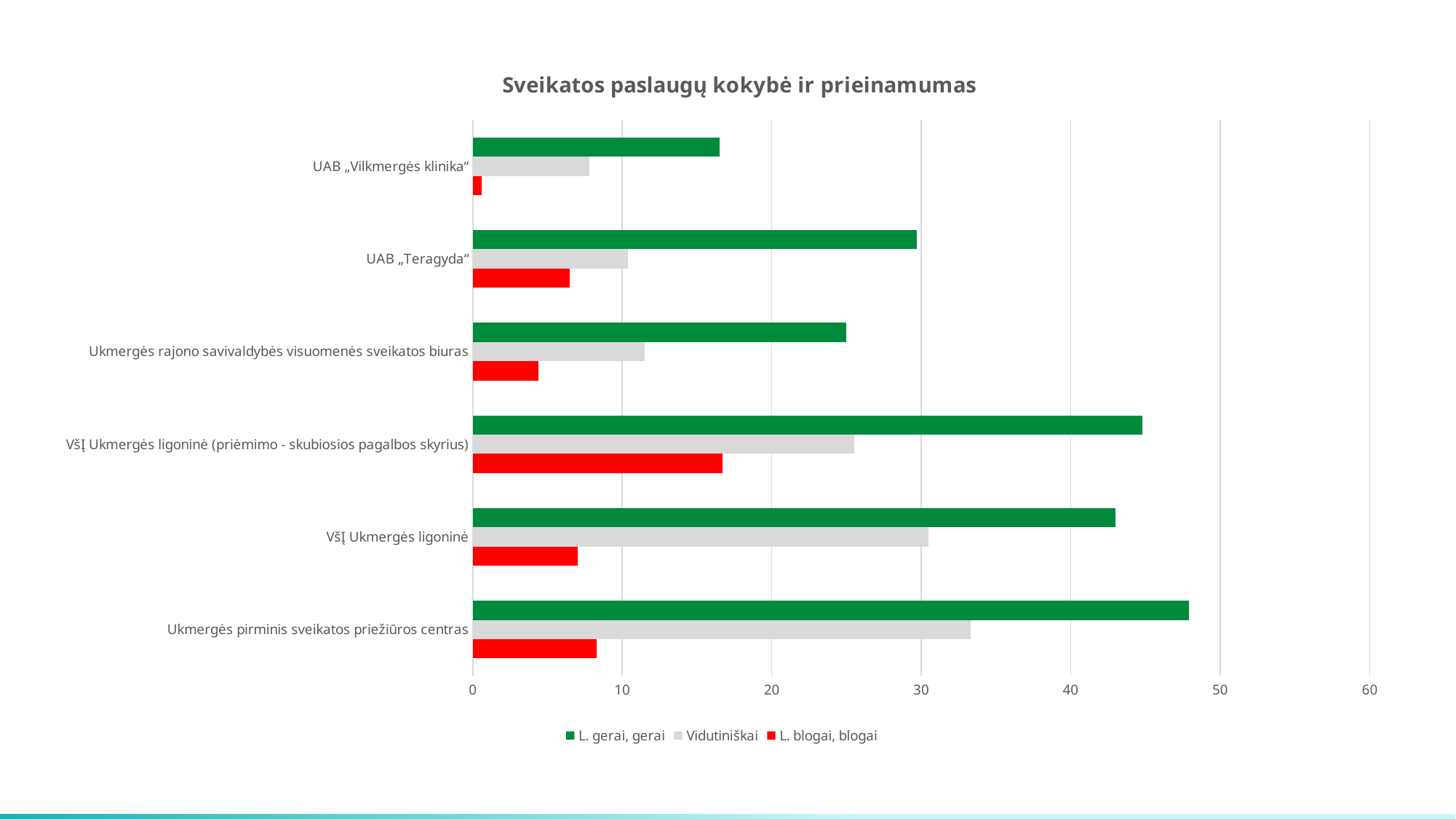
How many series does the legend list? 3 How many institutions (categories) are shown on the chart? 6 Which institution has the lowest value for "L. gerai, gerai"? UAB „Vilkmergės klinika“ Is the "Vidutiniškai" value for UAB „Vilkmergės klinika“ greater or less than 10? less Which is larger for VšĮ Ukmergės ligoninė: the "Vidutiniškai" value or the "L. blogai, blogai" value? Vidutiniškai What kind of chart is shown on the slide? bar chart Which institution has the highest value for "L. gerai, gerai"? Ukmergės pirminis sveikatos priežiūros centras Which institution has the lowest value for "L. blogai, blogai"? UAB „Vilkmergės klinika“ What is the title of the chart? Sveikatos paslaugų kokybė ir prieinamumas Is the "L. blogai, blogai" value for VšĮ Ukmergės ligoninė (priėmimo - skubiosios pagalbos skyrius) greater or less than 10? greater Is the "L. gerai, gerai" value for Ukmergės pirminis sveikatos priežiūros centras greater or less than 40? greater Which institution has the highest value for "L. blogai, blogai"? VšĮ Ukmergės ligoninė (priėmimo - skubiosios pagalbos skyrius)